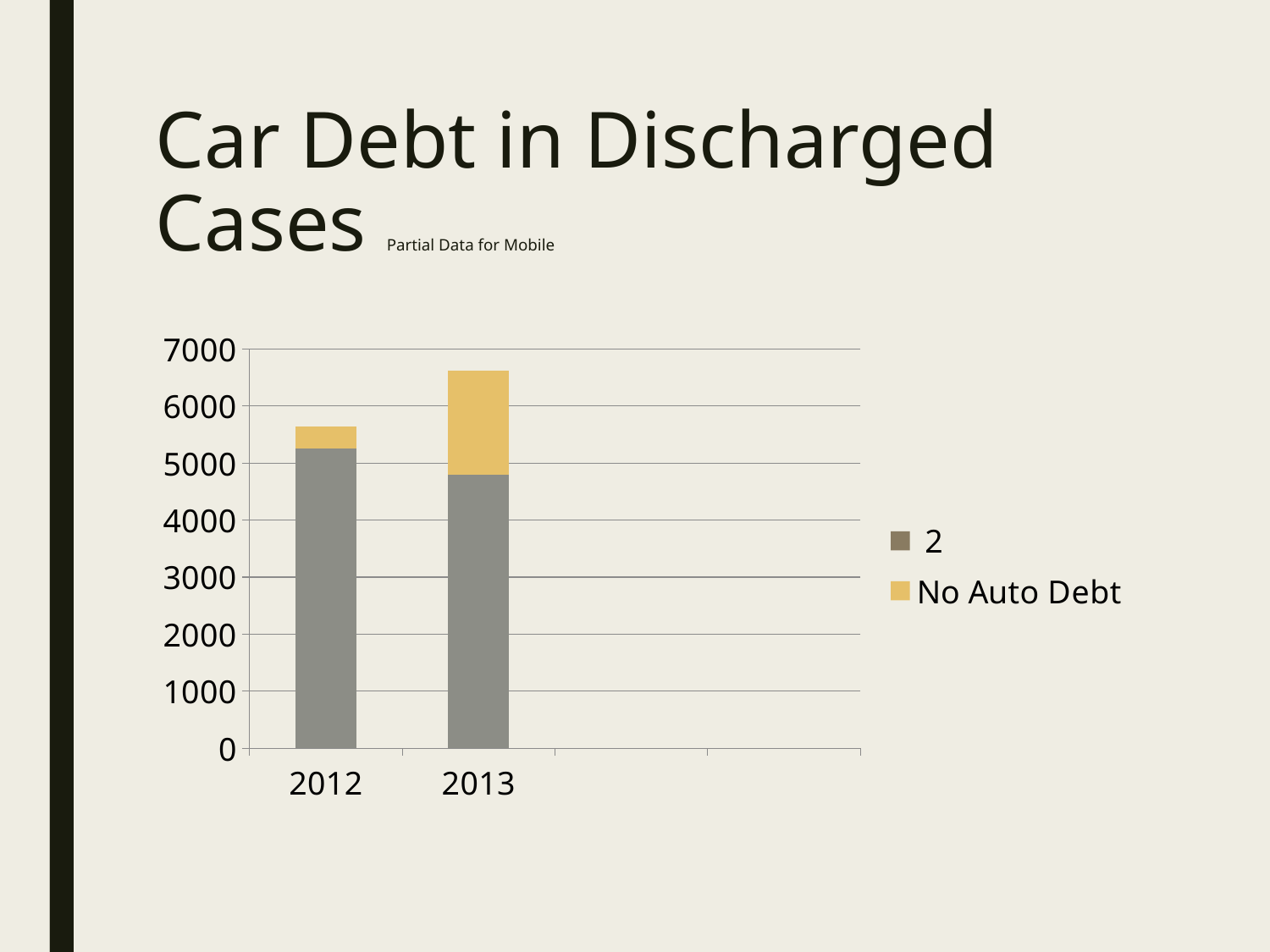
Is the total stacked bar for 2012 greater or less than 5000? greater Which year has the taller total stacked bar, 2012 or 2013? 2013 Is the '2' segment for 2013 greater or less than 4000? greater Is the total stacked bar for 2013 greater or less than 6000? greater What is the title of the slide containing the chart? Car Debt in Discharged Cases Does the total stacked bar rise or fall from 2012 to 2013? rise What kind of chart is shown on the slide? stacked bar chart Which year has the larger '2' segment, 2012 or 2013? 2012 How many series does the chart's legend list? 2 Which year has the larger 'No Auto Debt' segment, 2012 or 2013? 2013 How many years are shown on the x axis of the chart? 2 What are the two legend entries in the chart? 2 and No Auto Debt